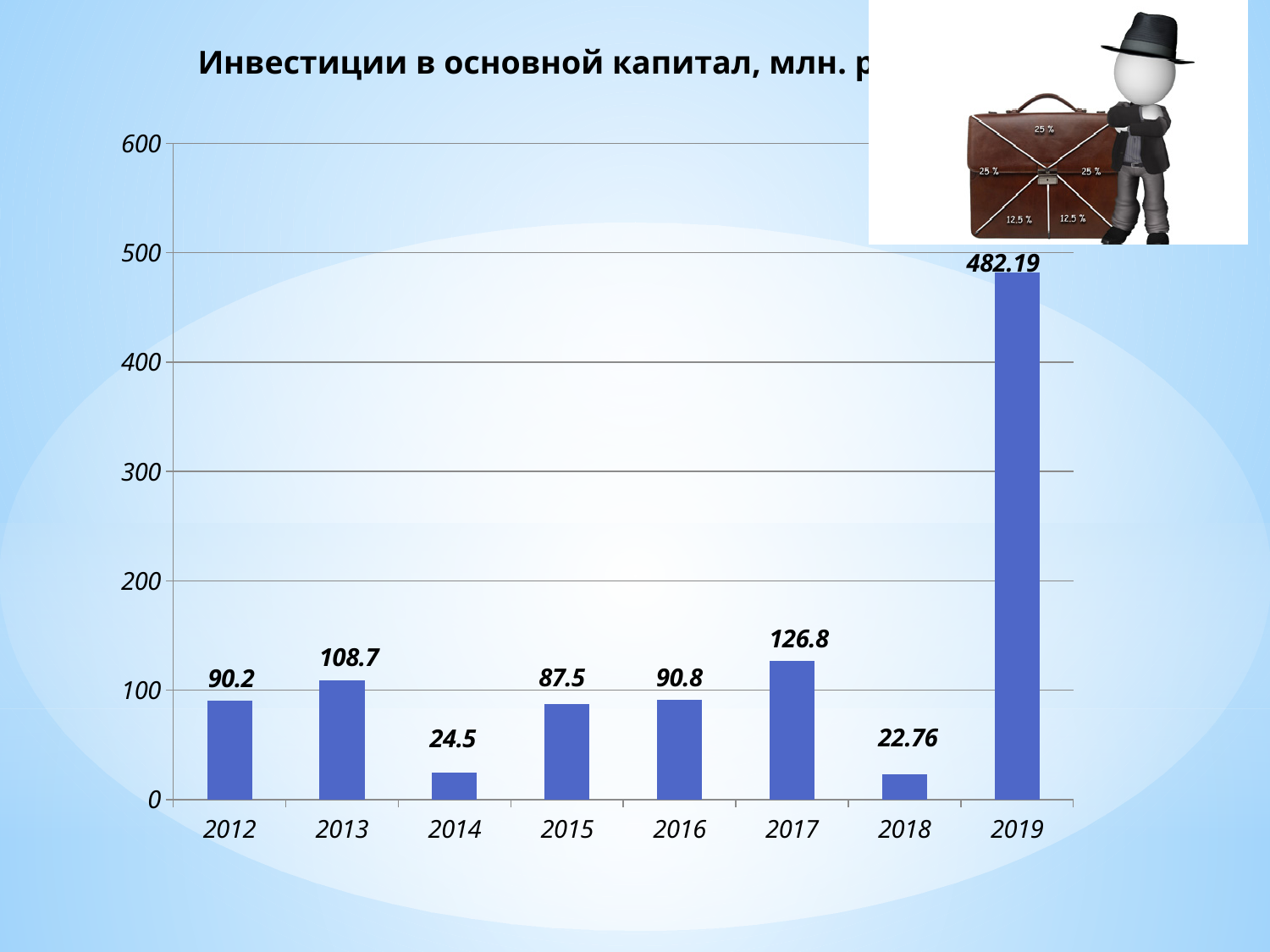
What is the difference between the values for 2017 and 2013? 18.1 What is the value for 2019? 482.19 What is the difference between the values for 2019 and 2018? 459.43 What is the value for 2017? 126.8 What is the value for 2014? 24.5 What kind of chart is shown on the slide? bar chart Which year has the lowest value? 2018 Which year has the highest value? 2019 How many years are shown on the x axis? 8 What is the value for 2018? 22.76 Is the value for 2019 greater or less than 400? greater Which is larger, the value for 2013 or the value for 2016? 2013